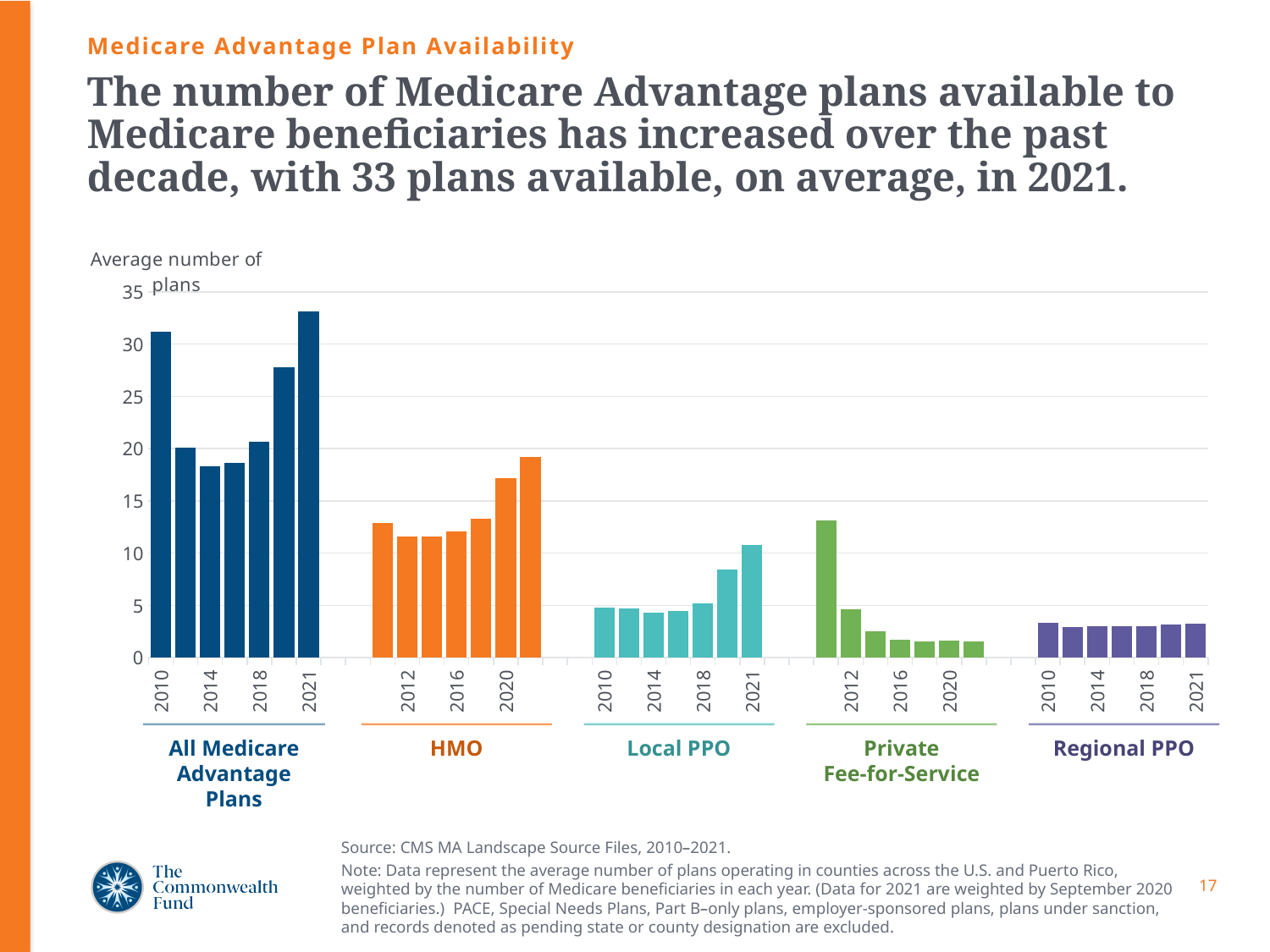
According to the slide, what was the average number of Medicare Advantage plans available in 2021? 33 What is the label on the vertical axis of the chart? Average number of plans What kind of chart is shown on the slide? bar chart How many plan-type groups are shown in the chart? 5 In the Private Fee-for-Service group, which year has the highest bar? 2010 Is the value for HMO in 2021 greater or less than 20? less Which is larger in 2021: the HMO value or the Local PPO value? HMO Is the value for Regional PPO in 2021 greater or less than 5? less In the All Medicare Advantage Plans group, which year has the highest bar? 2021 Do the Private Fee-for-Service values rise or fall from 2010 to 2021? fall How many bars are in the All Medicare Advantage Plans group? 7 Is the value for Private Fee-for-Service in 2010 greater or less than 10? greater